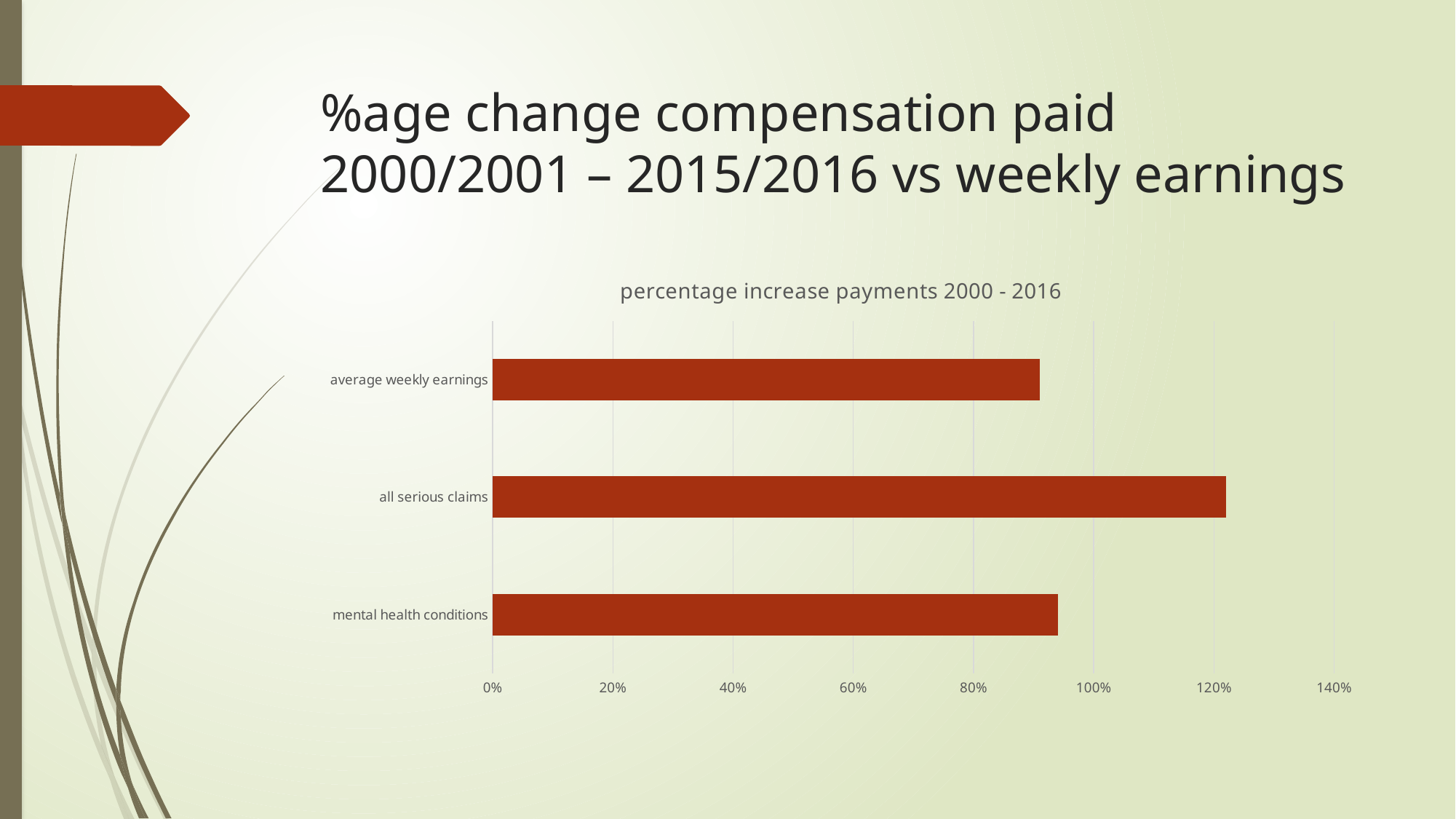
What is the highest value shown on the chart's horizontal axis? 140% Is the value for average weekly earnings greater or less than 80%? greater What is the title of the chart? percentage increase payments 2000 - 2016 Which category has the highest percentage increase in the chart? all serious claims Is the value for average weekly earnings greater or less than 100%? less Is the value for mental health conditions greater or less than 100%? less Which is larger, the value for all serious claims or the value for mental health conditions? all serious claims Which is larger, the value for all serious claims or the value for average weekly earnings? all serious claims How many categories are plotted in the chart? 3 What kind of chart is shown on the slide? bar chart